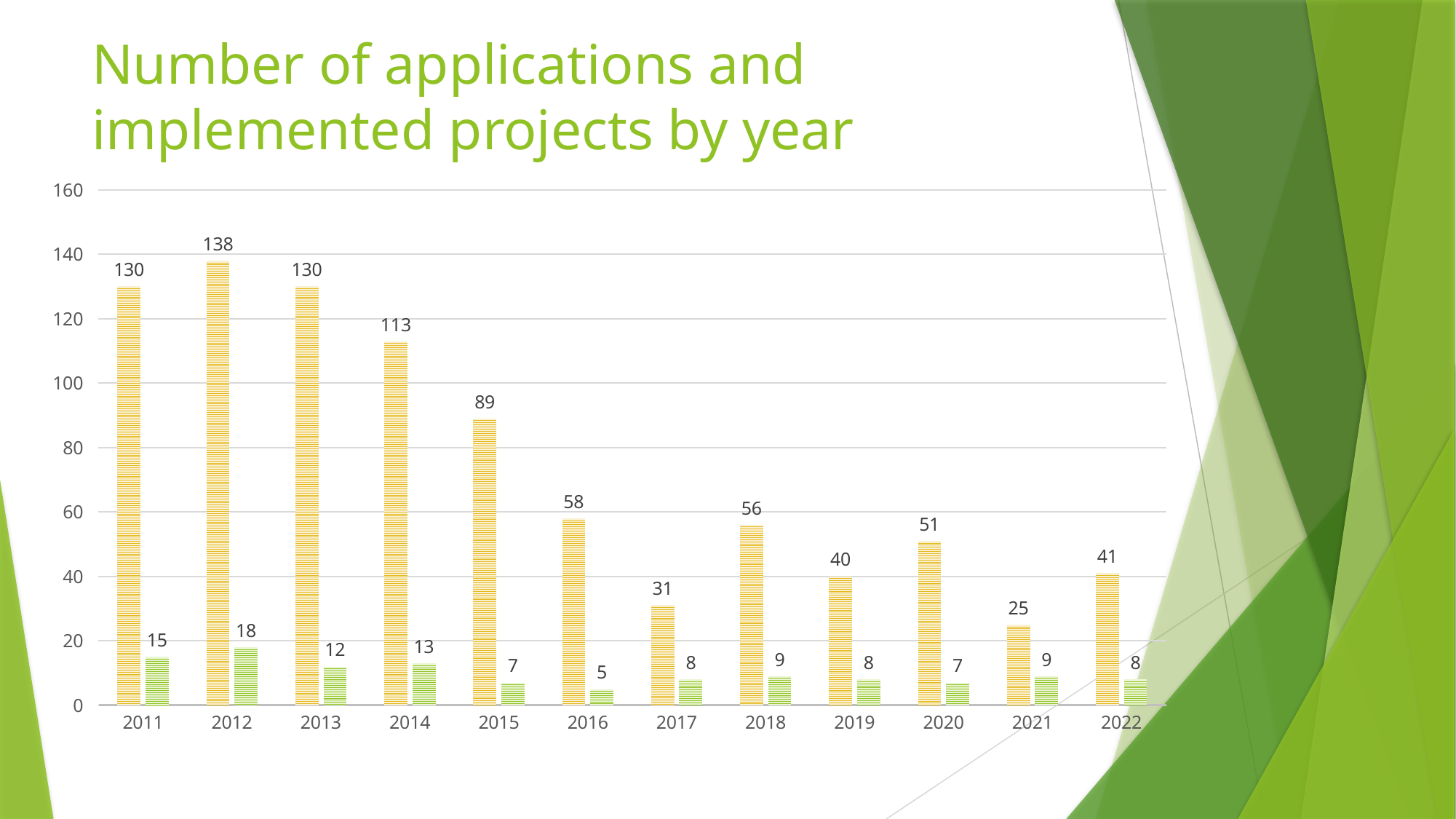
Which is larger, the orange bar for 2018 or the orange bar for 2020? 2018 Which year has the lowest orange bar? 2021 What kind of chart is shown on the slide? Bar chart What is the title of the chart on the slide? Number of applications and implemented projects by year What is the difference between the orange bar values for 2011 and 2014? 17 What is the value of the green bar for 2014? 13 Which year has the highest orange bar? 2012 How many years are shown on the x axis? 12 What is the value of the orange bar for 2019? 40 Which year has the highest green bar? 2012 Which year has the lowest green bar? 2016 What is the value of the orange bar for 2012? 138